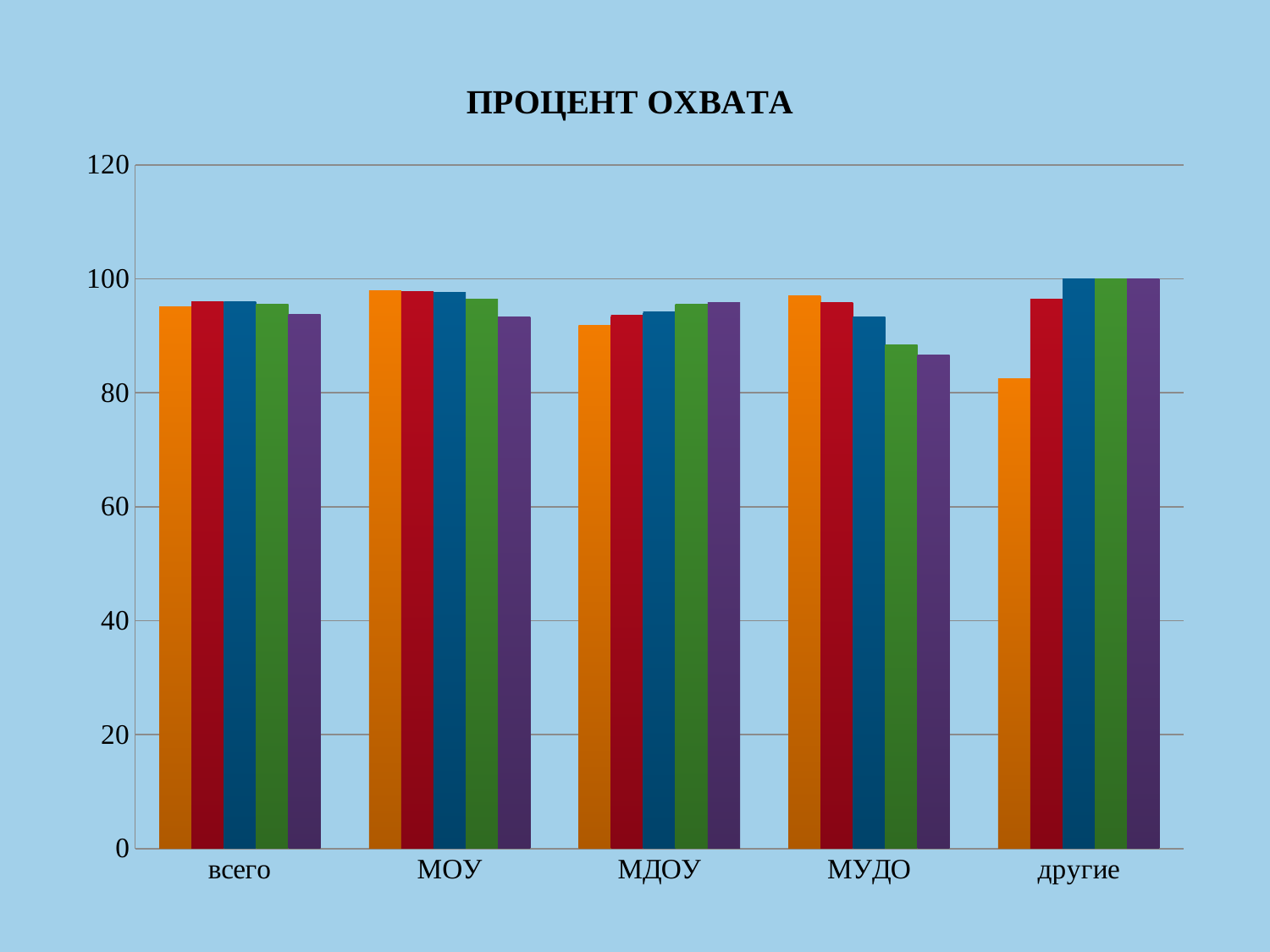
Is the value of the orange bar for МУДО greater or less than 80? greater What kind of chart is shown on the slide? bar chart For which category is the purple bar the lowest? МУДО Within the другие category, do the bars rise or fall from left to right? rise How many categories are shown on the x axis? 5 How many bars are plotted for each category? 5 For which category is the orange bar the lowest? другие Is the value of the green bar for МУДО greater or less than 100? less Is the value of the orange bar for МДОУ greater or less than 80? greater Which is larger: the orange bar for МОУ or the orange bar for другие? МОУ What value does the blue bar for другие reach on the axis? 100 What is the title of the chart? ПРОЦЕНТ ОХВАТА